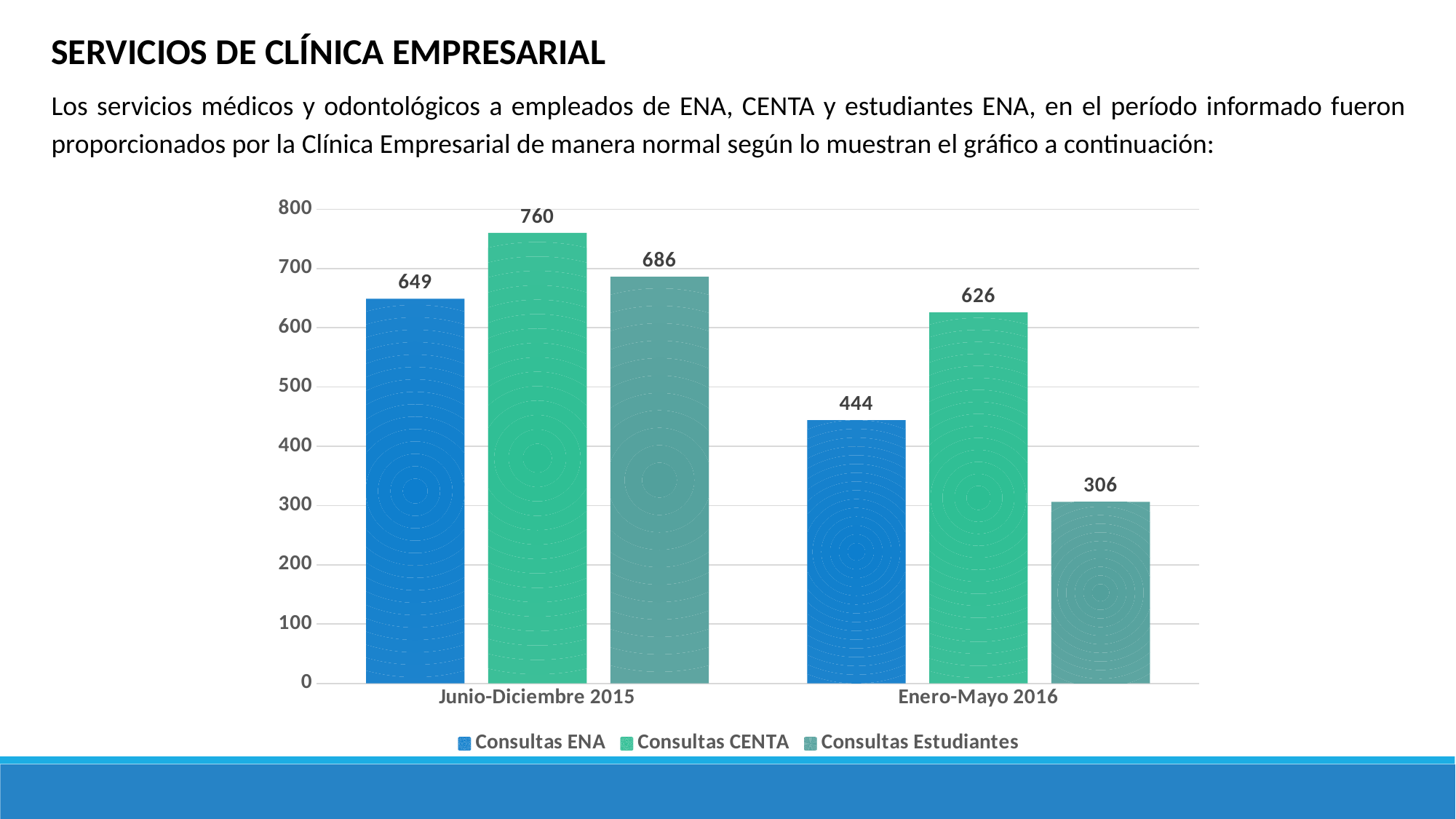
What is the difference between Consultas CENTA and Consultas ENA in Junio-Diciembre 2015? 111 How many series does the legend list? 3 Which series has the highest value in Junio-Diciembre 2015? Consultas CENTA What is the value for Consultas ENA in Junio-Diciembre 2015? 649 Which is larger: Consultas ENA in Junio-Diciembre 2015 or Consultas Estudiantes in Junio-Diciembre 2015? Consultas Estudiantes in Junio-Diciembre 2015 How many periods (categories) are shown on the x axis? 2 What is the difference between Consultas Estudiantes in Junio-Diciembre 2015 and Enero-Mayo 2016? 380 Do the values for Consultas ENA rise or fall from Junio-Diciembre 2015 to Enero-Mayo 2016? Fall What is the value for Consultas CENTA in Enero-Mayo 2016? 626 What kind of chart is shown on the slide? Bar chart Which series has the lowest value in Enero-Mayo 2016? Consultas Estudiantes What is the value for Consultas Estudiantes in Enero-Mayo 2016? 306